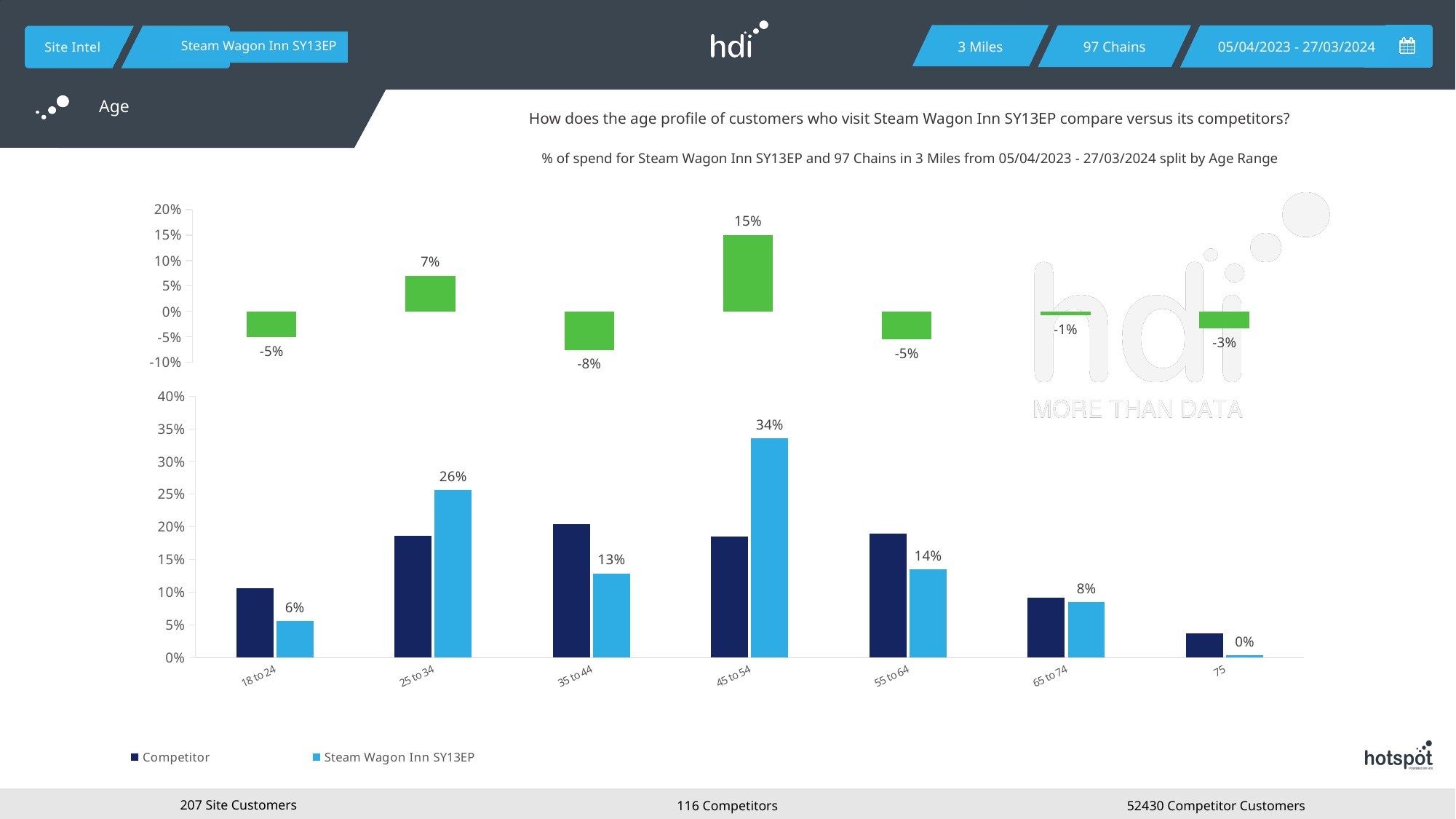
How many series does the legend of the bottom chart list? 2 What type of chart is the bottom chart? Bar chart In the bottom chart, what is the value for Steam Wagon Inn SY13EP in the 25 to 34 age range? 26% In the bottom chart, which age range has the lowest value for Steam Wagon Inn SY13EP? 75 In the bottom chart, what is the value for Steam Wagon Inn SY13EP in the 45 to 54 age range? 34% In the bottom chart, which age range has the highest value for Steam Wagon Inn SY13EP? 45 to 54 In the top chart, what is the value for the 45 to 54 age range? 15% In the top chart, which age range has the lowest value? 35 to 44 How many age range categories are shown on the x axis of the bottom chart? 7 In the bottom chart, what is the difference between the Steam Wagon Inn SY13EP values for 45 to 54 and 25 to 34? 8% In the bottom chart, which is larger for the 55 to 64 age range: the Competitor bar or the Steam Wagon Inn SY13EP bar? Competitor In the bottom chart, is the Competitor value for 35 to 44 greater or less than 15%? greater